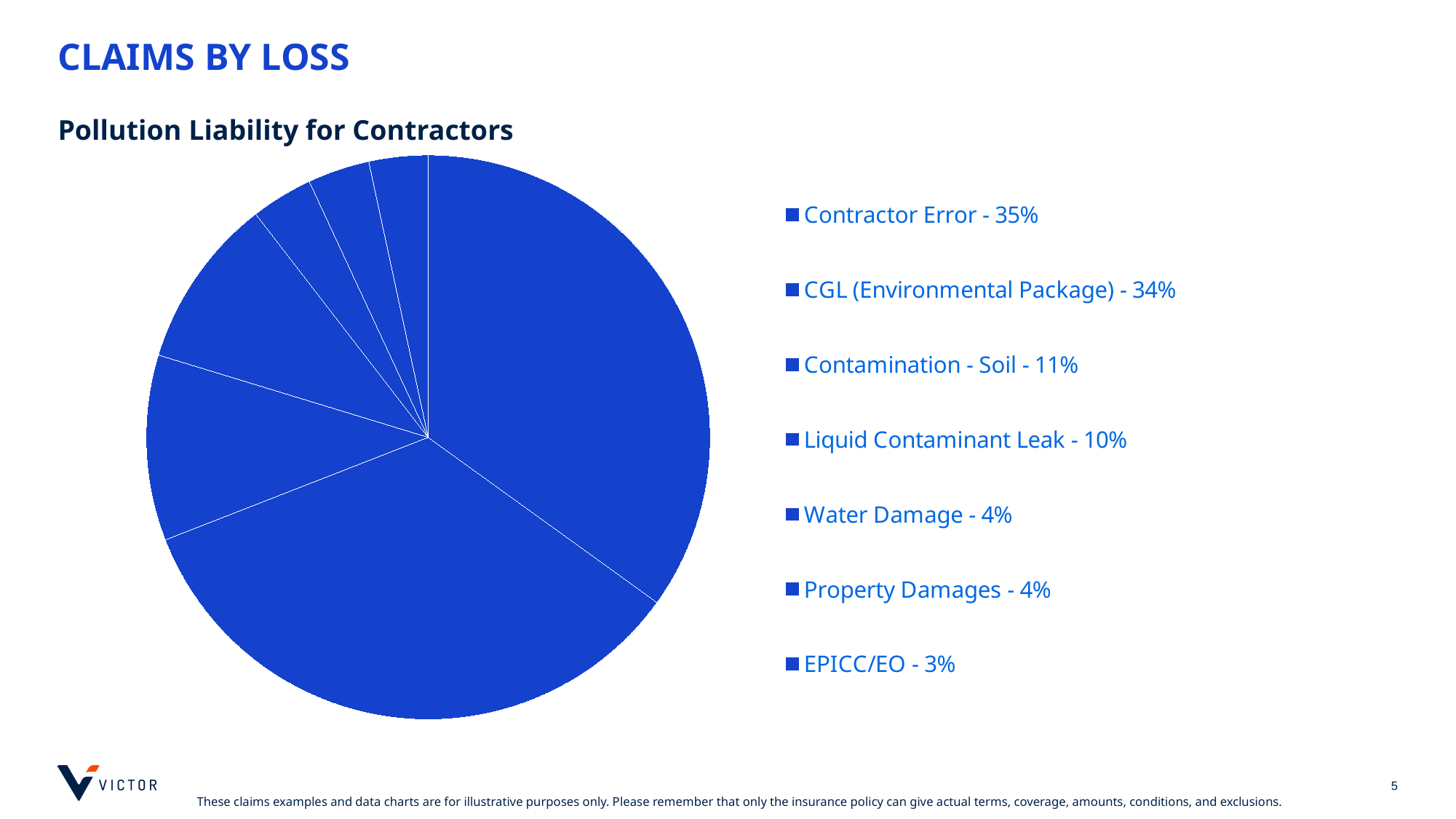
What share of claims is attributed to Contractor Error? 35% What share of claims is attributed to CGL (Environmental Package)? 34% What share of claims is attributed to Contamination - Soil? 11% What share of claims is attributed to Liquid Contaminant Leak? 10% How many categories does the legend list? 7 What share of claims is attributed to EPICC/EO? 3% What is the difference in percentage points between Contractor Error and Contamination - Soil? 24 Which category has the largest share of claims? Contractor Error What is the subtitle shown above the pie chart? Pollution Liability for Contractors Which category has the smallest share of claims? EPICC/EO Which is larger, the share for Contamination - Soil or the share for Liquid Contaminant Leak? Contamination - Soil What kind of chart is shown on the slide? pie chart